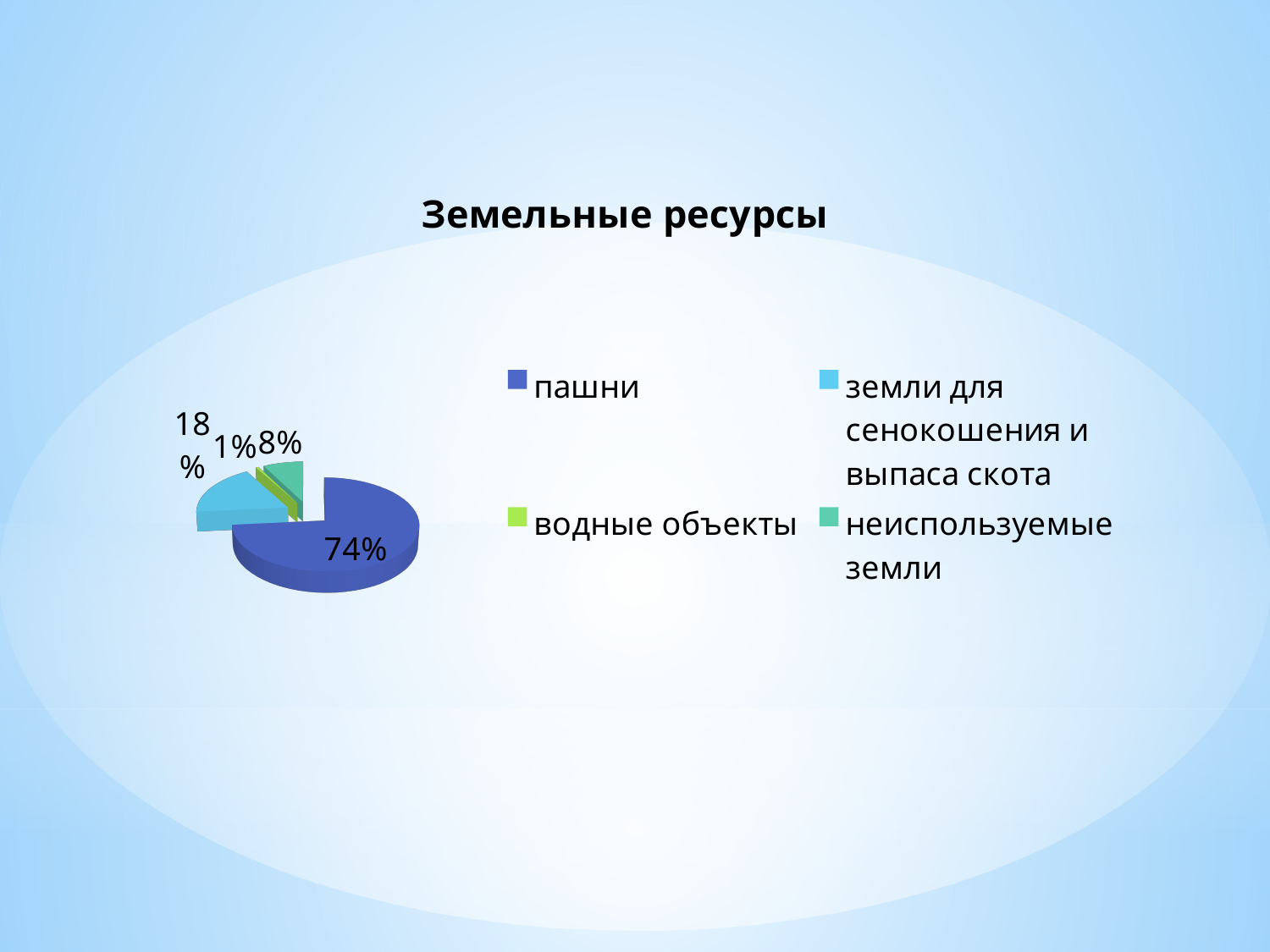
What share of the pie does неиспользуемые земли take? 8% Which is larger: the share of неиспользуемые земли or the share of водные объекты? неиспользуемые земли What share of the pie does земли для сенокошения и выпаса скота take? 18% Which category has the largest slice of the pie? пашни What is the title of the chart? Земельные ресурсы What is the difference between the share of пашни and the share of земли для сенокошения и выпаса скота? 56% Which category has the smallest slice of the pie? водные объекты What kind of chart is shown on the slide? pie chart What colour is the slice for пашни? dark blue How many categories does the legend list? 4 What share of the pie does пашни take? 74%